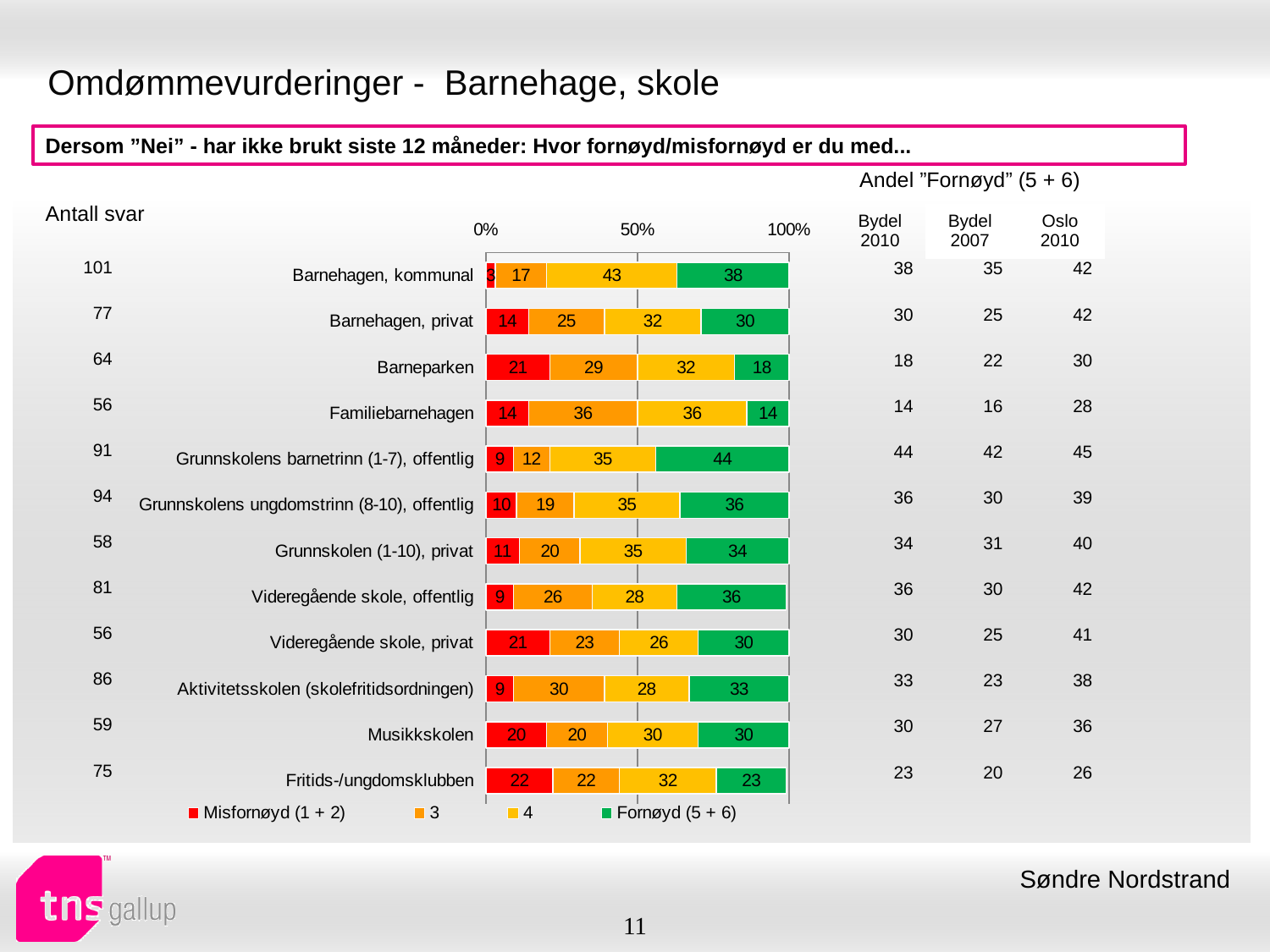
How many categories are shown in the chart? 12 Which category has the highest "Fornøyd (5 + 6)" value? Grunnskolens barnetrinn (1-7), offentlig What is the total of the stacked bar for Musikkskolen? 100 What kind of chart is shown on the slide? Stacked bar chart What is the value of the "4" segment for Barnehagen, kommunal? 43 What is the value of the "Misfornøyd (1 + 2)" segment for Barneparken? 21 Which category has the lowest "Fornøyd (5 + 6)" value? Familiebarnehagen What is the difference between the "Fornøyd (5 + 6)" values for Grunnskolens barnetrinn (1-7), offentlig and Familiebarnehagen? 30 What is the value of the "3" segment for Aktivitetsskolen (skolefritidsordningen)? 30 How many series does the legend list? 4 Which has a larger "Fornøyd (5 + 6)" value: Barnehagen, kommunal or Barneparken? Barnehagen, kommunal What is the value of the "Fornøyd (5 + 6)" segment for Grunnskolens barnetrinn (1-7), offentlig? 44